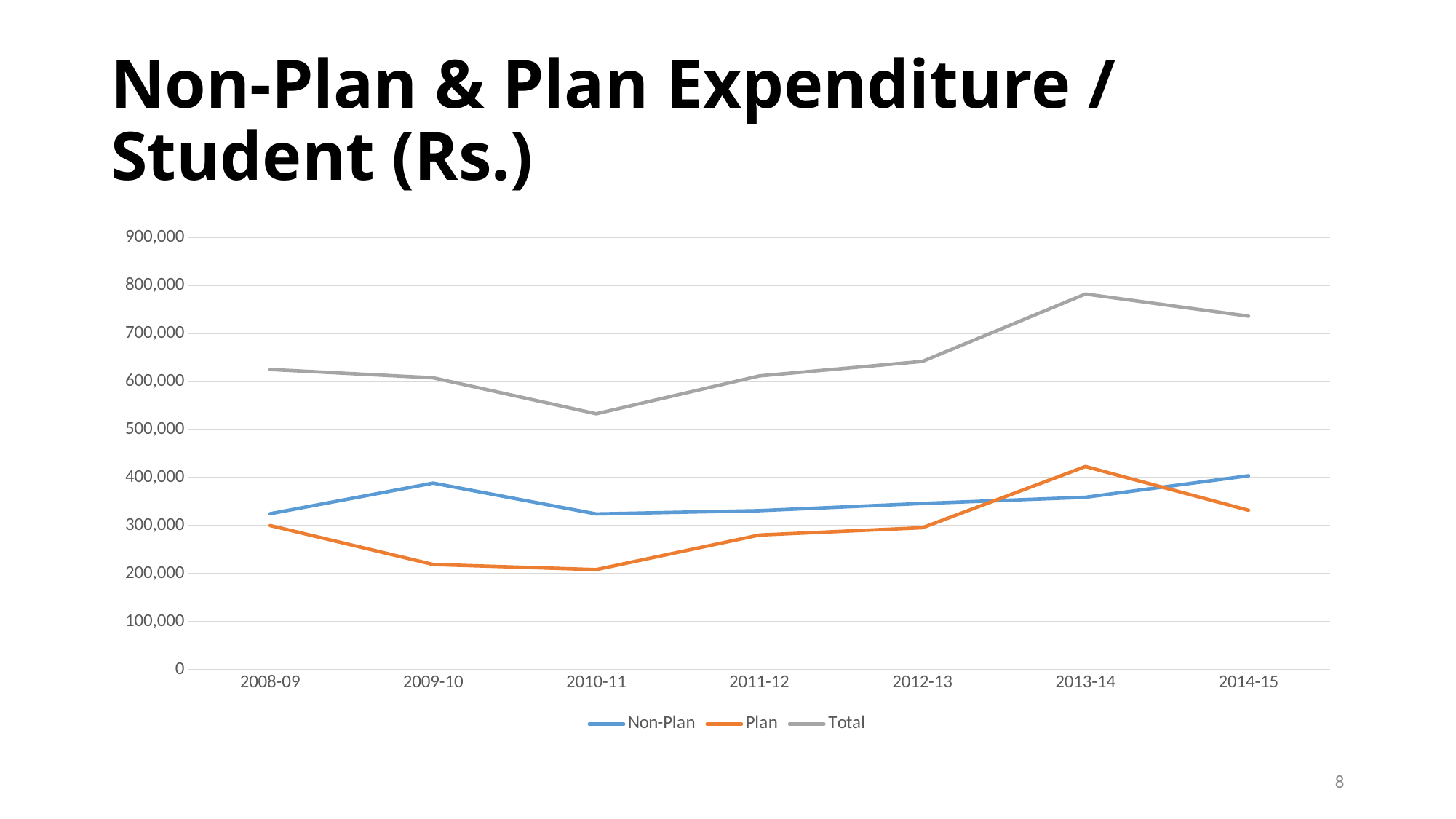
In which year is the Total expenditure per student highest? 2013-14 Which colour is used for the Plan series? orange How many years are plotted along the x axis? 7 In which year is the Plan expenditure per student highest? 2013-14 Is the Plan value for 2010-11 greater or less than 300,000? less What kind of chart is shown on the slide? line chart Does the Total expenditure per student rise or fall from 2010-11 to 2013-14? rise In which year is the Plan expenditure per student lowest? 2010-11 In 2013-14, which is larger, the Plan or the Non-Plan expenditure per student? Plan In which year is the Total expenditure per student lowest? 2010-11 How many series does the legend list? 3 Is the Total value for 2013-14 greater or less than 700,000? greater